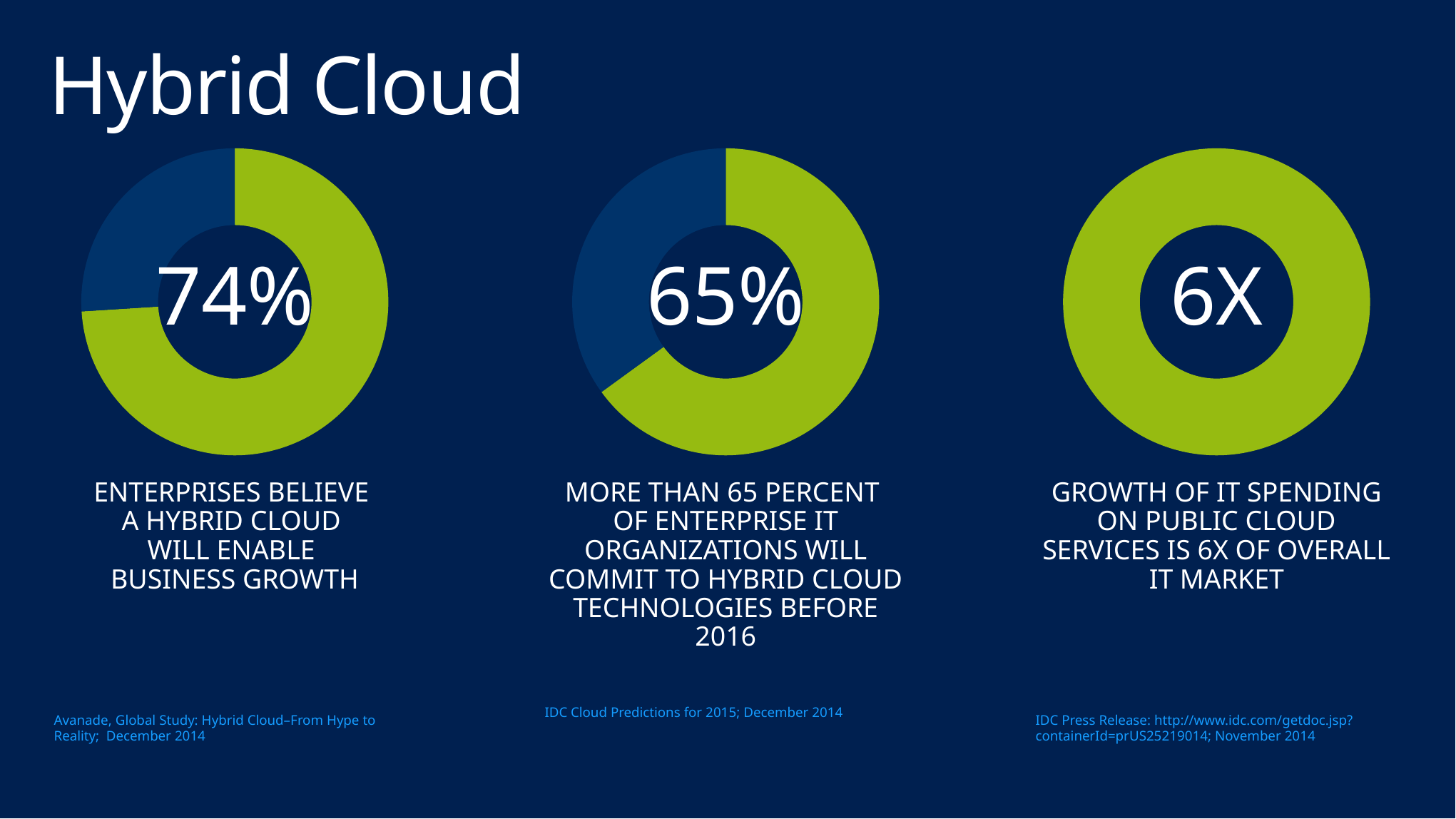
What colour is used for the highlighted segment in each donut chart? Green What value is shown in the centre of the middle donut chart? 65% In the middle donut chart, what share of the ring is the dark blue segment? 35% What value is shown in the centre of the right donut chart? 6X What is the difference between the percentage in the left donut chart and the percentage in the middle donut chart? 9 percentage points How many donut charts are on the slide? 3 Which shows a larger percentage, the left donut chart or the middle donut chart? The left donut chart (74%) What value is shown in the centre of the left donut chart? 74% What kind of charts are shown on the slide? Donut (pie) charts What is the title of the slide containing the donut charts? Hybrid Cloud In the left donut chart, what share of the ring is the green segment? 74% In the left donut chart, what share of the ring is the dark blue segment? 26%